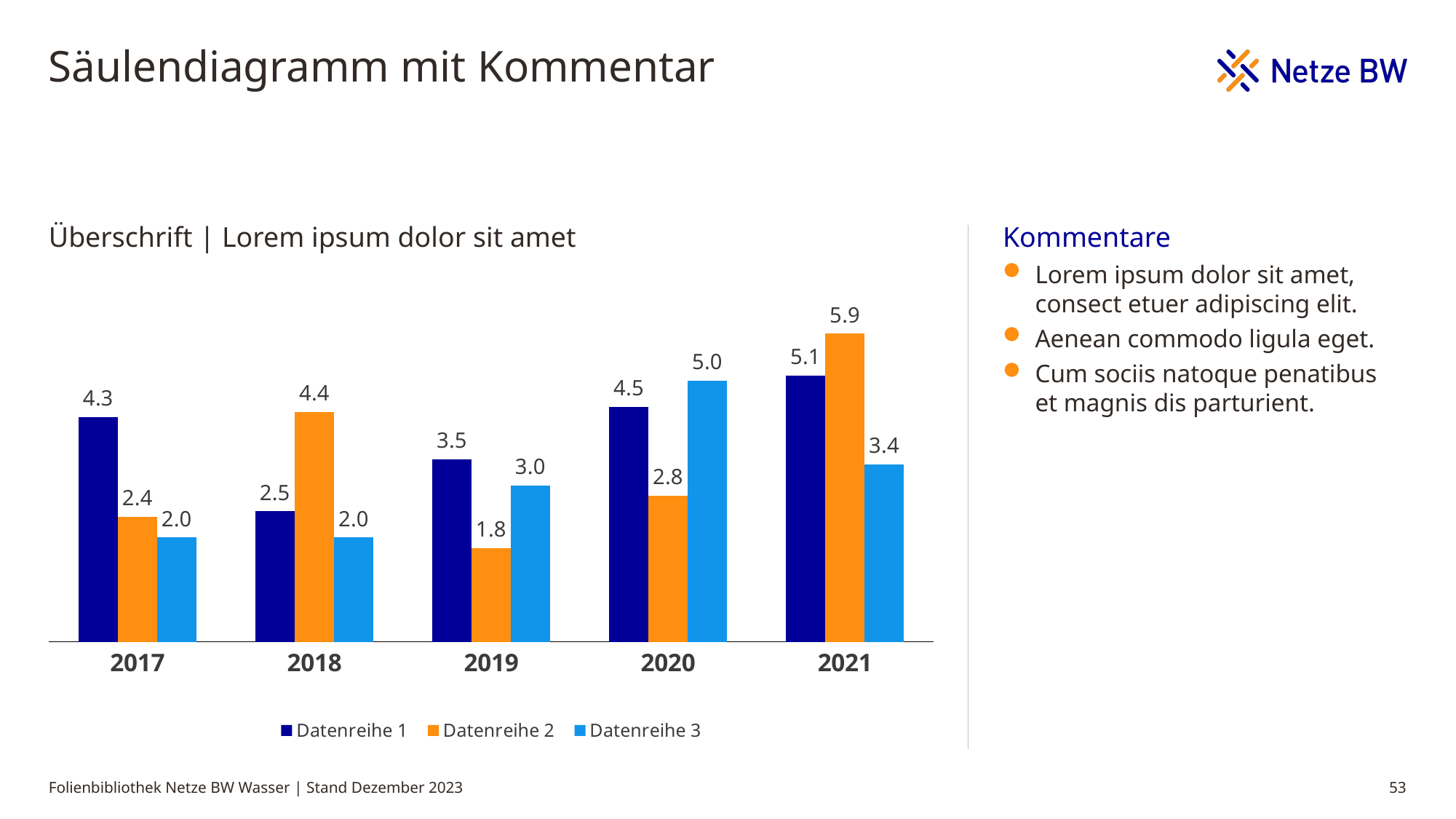
What is the title of the chart? Überschrift | Lorem ipsum dolor sit amet What is the difference between Datenreihe 1 and Datenreihe 3 in 2021? 1.7 What is the value for Datenreihe 3 in 2020? 5.0 Which year has the highest value for Datenreihe 2? 2021 Does the value for Datenreihe 3 rise or fall from 2017 to 2020? Rise Which is larger in 2019: Datenreihe 1 or Datenreihe 3? Datenreihe 1 What kind of chart is shown on the slide? Bar chart How many years are shown on the x axis? 5 Which year has the lowest value for Datenreihe 1? 2018 What is the value for Datenreihe 2 in 2021? 5.9 What is the value for Datenreihe 1 in 2017? 4.3 How many series does the legend list? 3